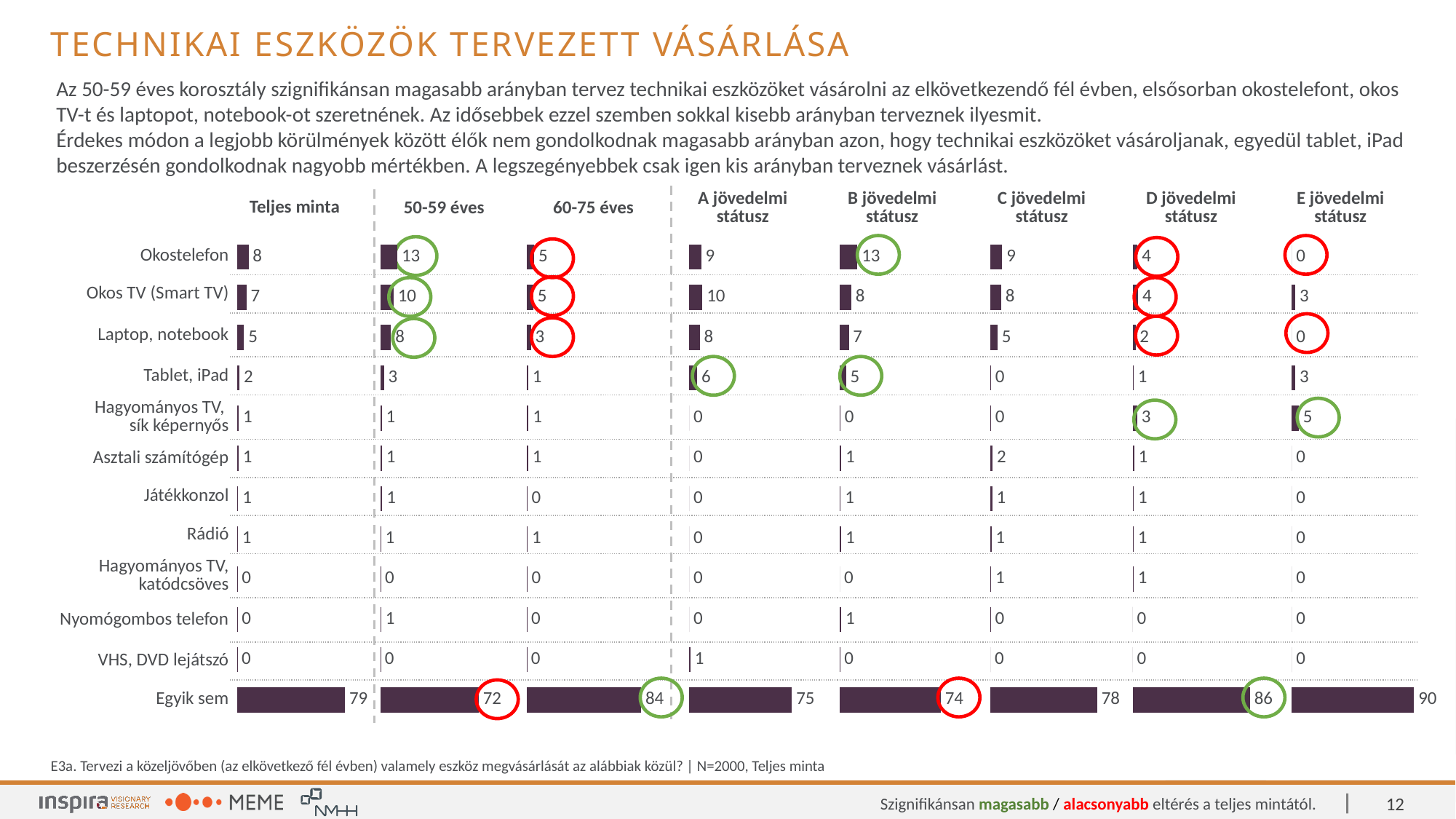
What is the difference between the Okostelefon values in the "50-59 éves" chart and the "60-75 éves" chart? 8 In the "E jövedelmi státusz" chart, what is the value for Egyik sem? 90 In the "60-75 éves" chart, which category has the highest value? Egyik sem What is the difference between the Egyik sem values in the "E jövedelmi státusz" chart and the "B jövedelmi státusz" chart? 16 What kind of chart is used for the "Teljes minta" column? Bar chart How many categories are listed in each chart on the slide? 12 In the "A jövedelmi státusz" chart, what is the value for Tablet, iPad? 6 In the "50-59 éves" chart, what is the value for Okos TV (Smart TV)? 10 In the "Teljes minta" chart, what is the value for Okostelefon? 8 In the "D jövedelmi státusz" chart, what is the value for Laptop, notebook? 2 Which is larger: the Egyik sem value in the "50-59 éves" chart or in the "60-75 éves" chart? 60-75 éves How many separate bar charts (columns) are shown on the slide? 8